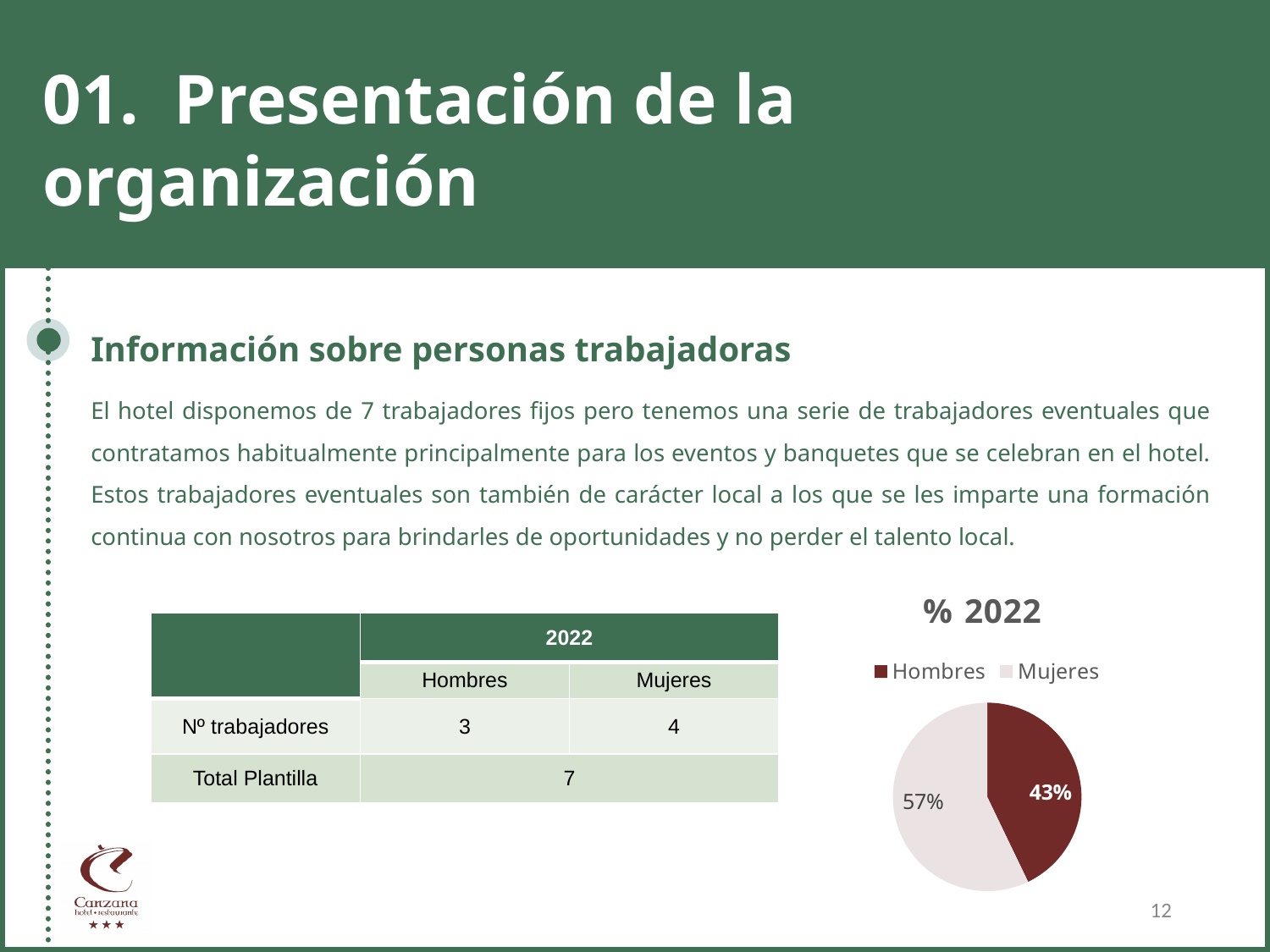
What share of the pie does Mujeres represent? 57% What is the difference in percentage points between the Mujeres and Hombres slices? 14% Which legend entry is shown in dark red? Hombres Which slice is the largest in the pie chart? Mujeres How many slices does the pie chart have? 2 What kind of chart is shown on the slide? pie chart What is the title of the chart? % 2022 Which slice is the smallest in the pie chart? Hombres What share of the pie does Hombres represent? 43% How many entries does the legend list? 2 Which is larger, the Hombres slice or the Mujeres slice? Mujeres